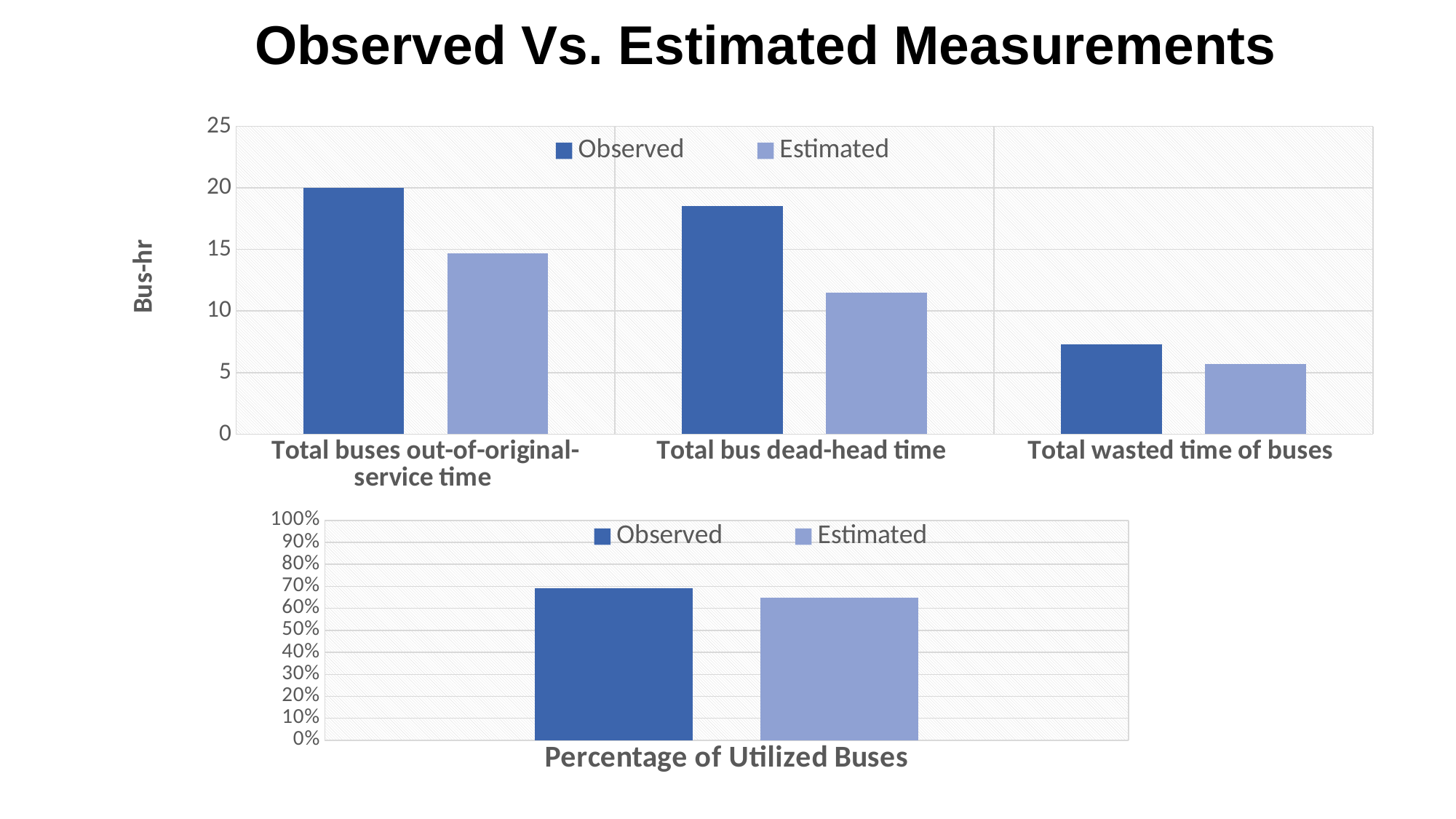
On the top chart (Bus-hr), is the Observed value for Total wasted time of buses greater or less than 10? less On the top chart (Bus-hr), how many categories are shown on the x axis? 3 On the top chart (Bus-hr), what kind of chart is shown? bar chart On the top chart (Bus-hr), is the Observed value for Total bus dead-head time greater or less than 15? greater On the top chart (Bus-hr), what is the label of the y axis? Bus-hr On the top chart (Bus-hr), how many series does the legend list? 2 On the top chart (Bus-hr), which category has the highest Observed value? Total buses out-of-original-service time On the top chart (Bus-hr), for Total buses out-of-original-service time, which is larger, the Observed or the Estimated value? Observed On the bottom chart (Percentage of Utilized Buses), which is larger, the Observed or the Estimated value? Observed On the top chart (Bus-hr), is the Estimated value for Total bus dead-head time greater or less than 10? greater On the top chart (Bus-hr), which category has the lowest Estimated value? Total wasted time of buses